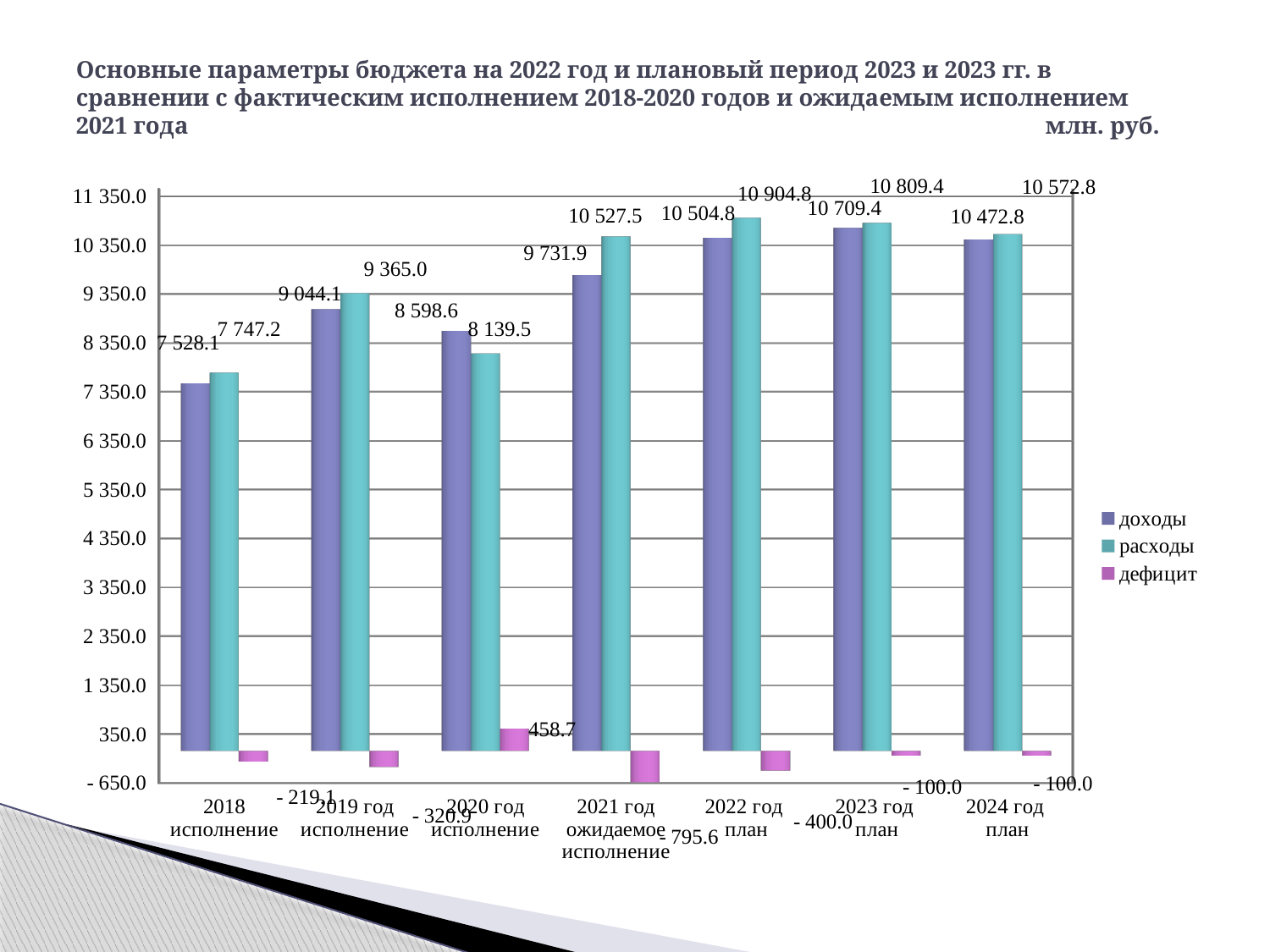
What unit of measurement is stated at the top right of the slide? млн. руб. Which category has the highest value of расходы? 2022 год план How many series does the legend list? 3 What is the difference between расходы and доходы for 2022 год план? 400.0 Is the value of доходы for 2023 год план greater or less than 10 350.0? greater How many categories are shown on the x axis? 7 What is the value of расходы for 2021 год ожидаемое исполнение? 10 527.5 For 2020 год исполнение, which is larger: доходы or расходы? доходы What is the value of дефицит for 2020 год исполнение? 458.7 What kind of chart is shown on the slide? bar chart What is the value of доходы for 2019 год исполнение? 9 044.1 Which category has the lowest value of доходы? 2018 исполнение